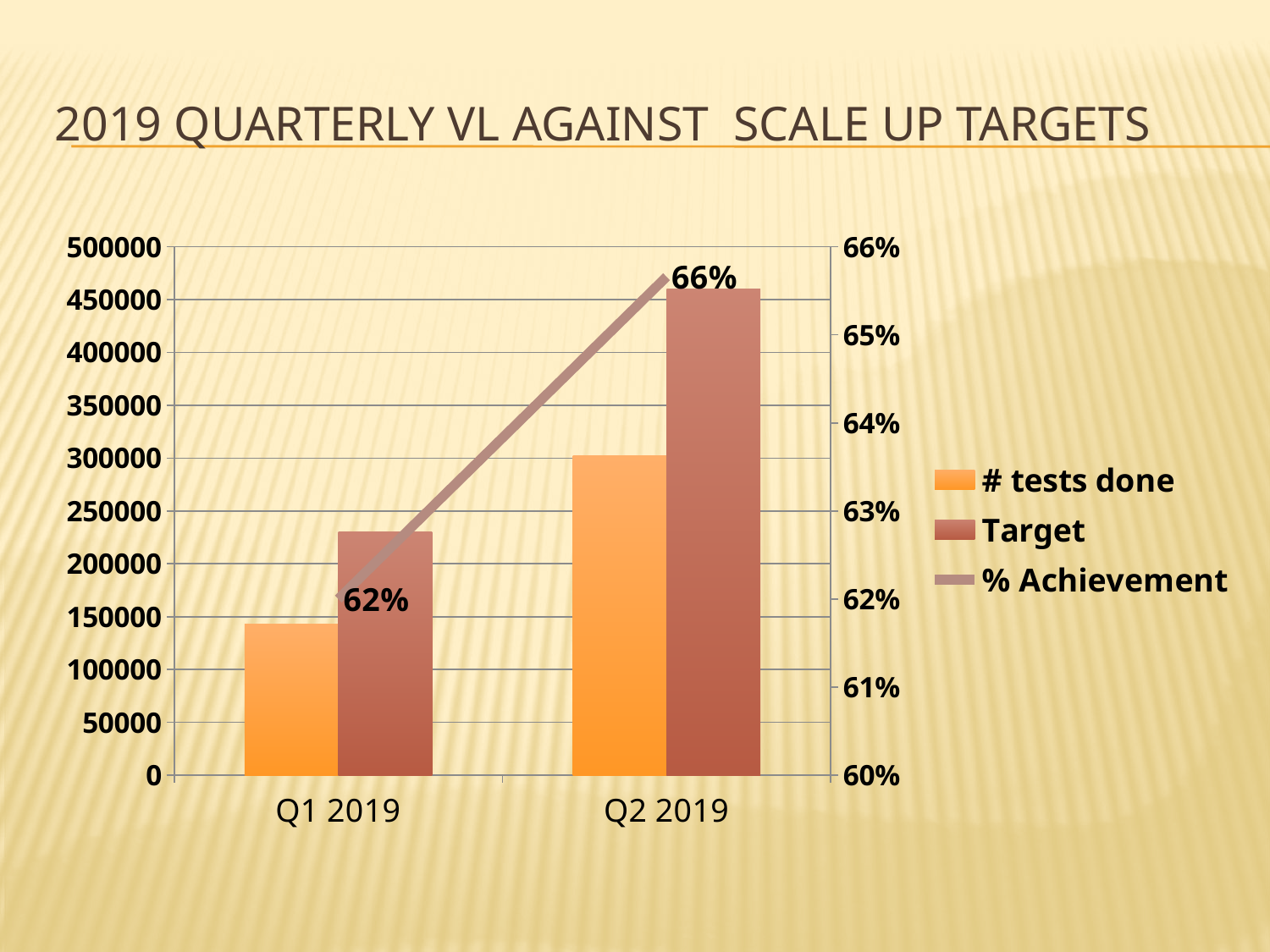
Is the # tests done value for Q2 2019 greater or less than 250000? greater What is the % Achievement for Q1 2019? 62% What is the title of the chart on this slide? 2019 QUARTERLY VL AGAINST SCALE UP TARGETS Is the # tests done value for Q1 2019 greater or less than 150000? less How many series does the legend list? 3 Is the Target value for Q2 2019 greater or less than 400000? greater Which is larger for Q1 2019, # tests done or Target? Target By how many percentage points did % Achievement change from Q1 2019 to Q2 2019? 4 percentage points Which quarter has the higher % Achievement? Q2 2019 What is the % Achievement for Q2 2019? 66% How many quarters are shown on the x axis? 2 Does the % Achievement line rise or fall from Q1 2019 to Q2 2019? rise